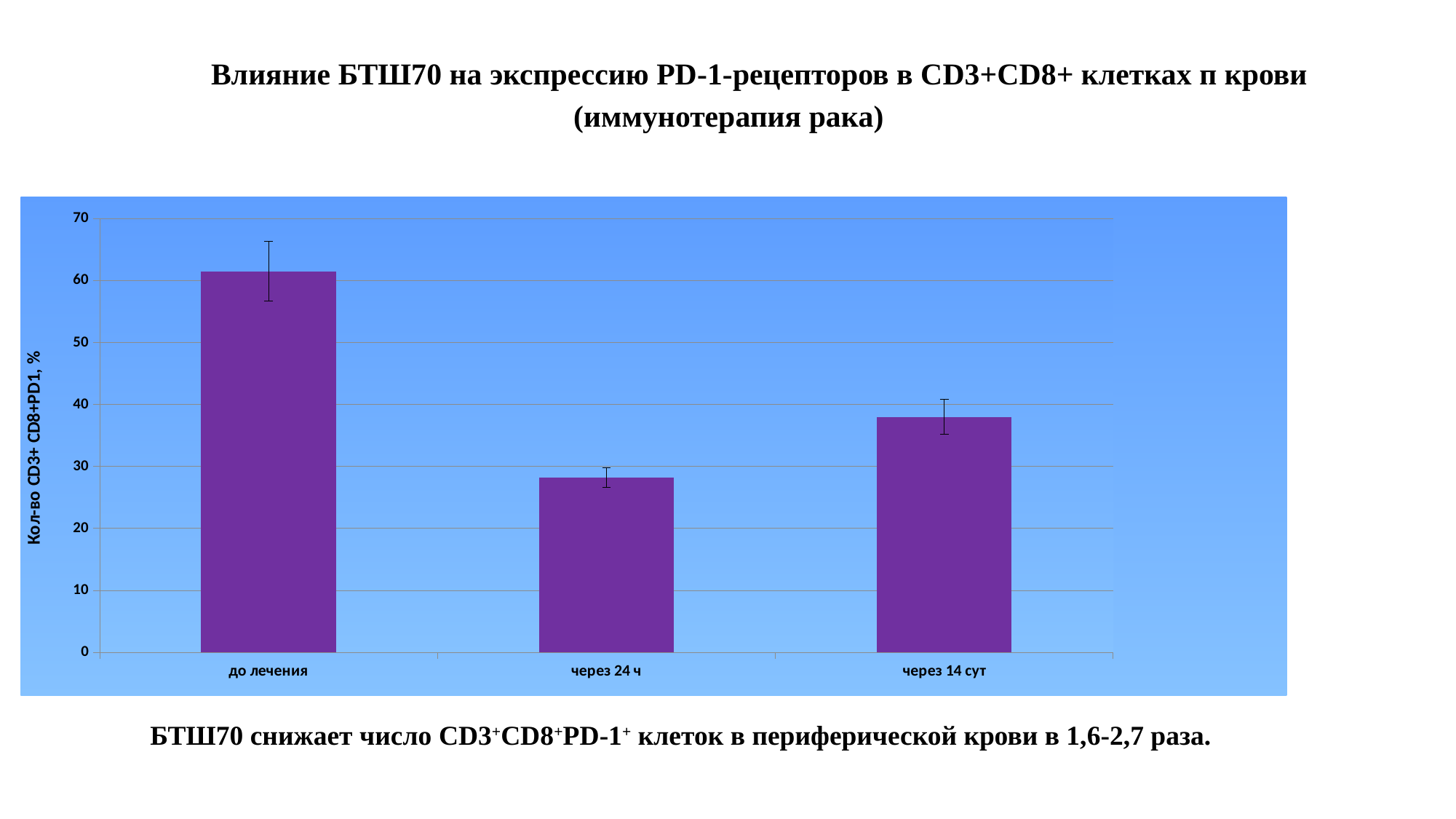
Does the value rise or fall from "до лечения" to "через 24 ч"? fall Which is larger, the value for "через 24 ч" or the value for "через 14 сут"? через 14 сут Is the value for "через 24 ч" greater or less than 30? less How many categories are shown on the x axis of the chart? 3 Which category has the lowest value in the chart? через 24 ч Is the value for "через 14 сут" greater or less than 40? less Is the value for "до лечения" greater or less than 60? greater What kind of chart is shown on the slide? bar chart Which category has the highest value in the chart? до лечения What is the highest tick value shown on the vertical axis? 70 Which is larger, the value for "до лечения" or the value for "через 14 сут"? до лечения What is the label of the vertical axis of the chart? Кол-во CD3+ CD8+PD1, %